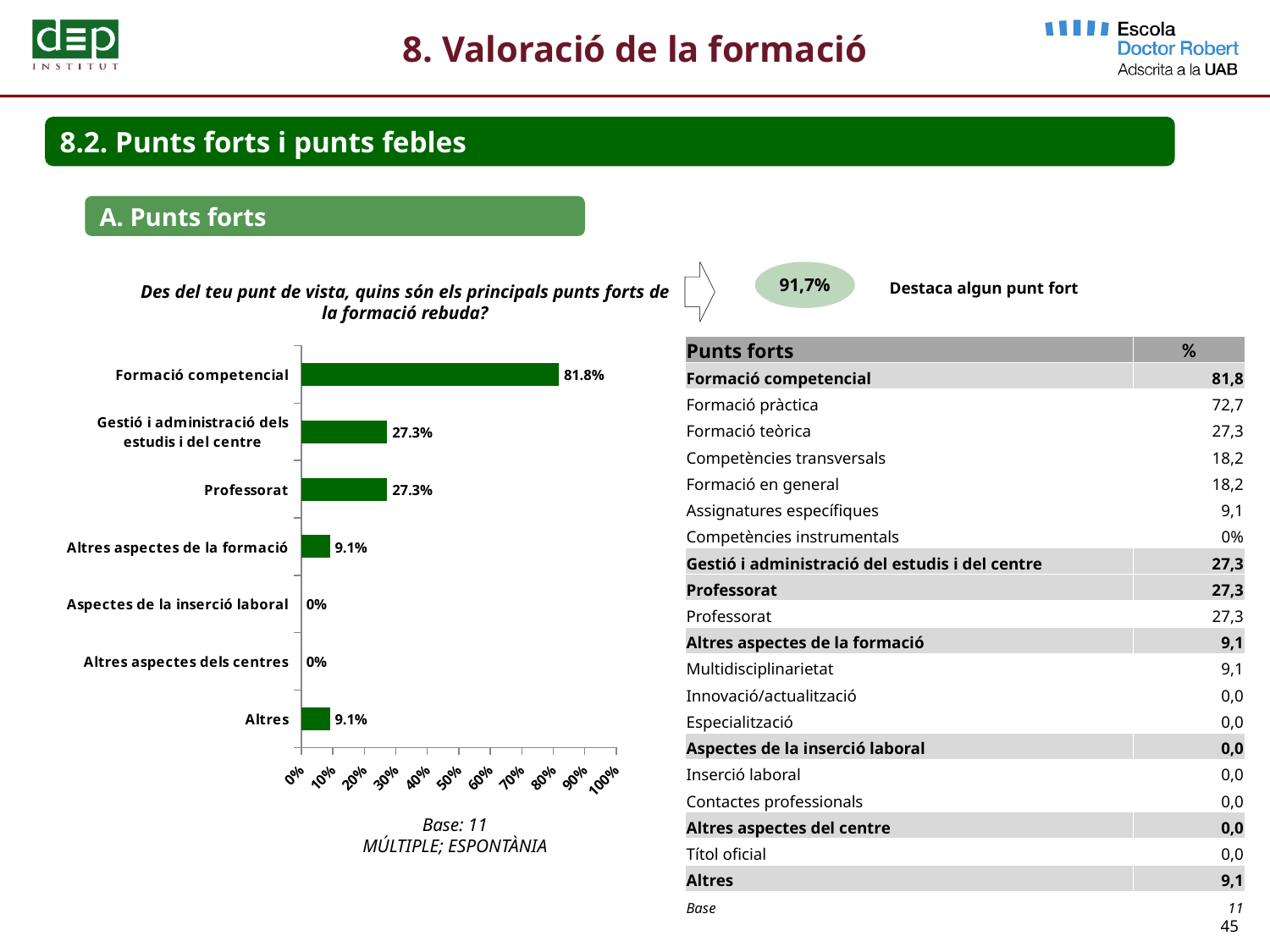
What is the difference between the values for Professorat and Altres aspectes de la formació? 18.2% What is the difference between the values for Formació competencial and Professorat? 54.5% What is the value for Formació competencial? 81.8% What is the value for Altres? 9.1% Which category has the highest value? Formació competencial Is the value for Formació competencial greater or less than 80%? greater How many categories are shown in the chart? 7 What kind of chart is shown on the slide? bar chart What is the value for Gestió i administració dels estudis i del centre? 27.3% Which is larger, the value for Professorat or the value for Altres? Professorat What is the value for Aspectes de la inserció laboral? 0% What is the value for Altres aspectes de la formació? 9.1%